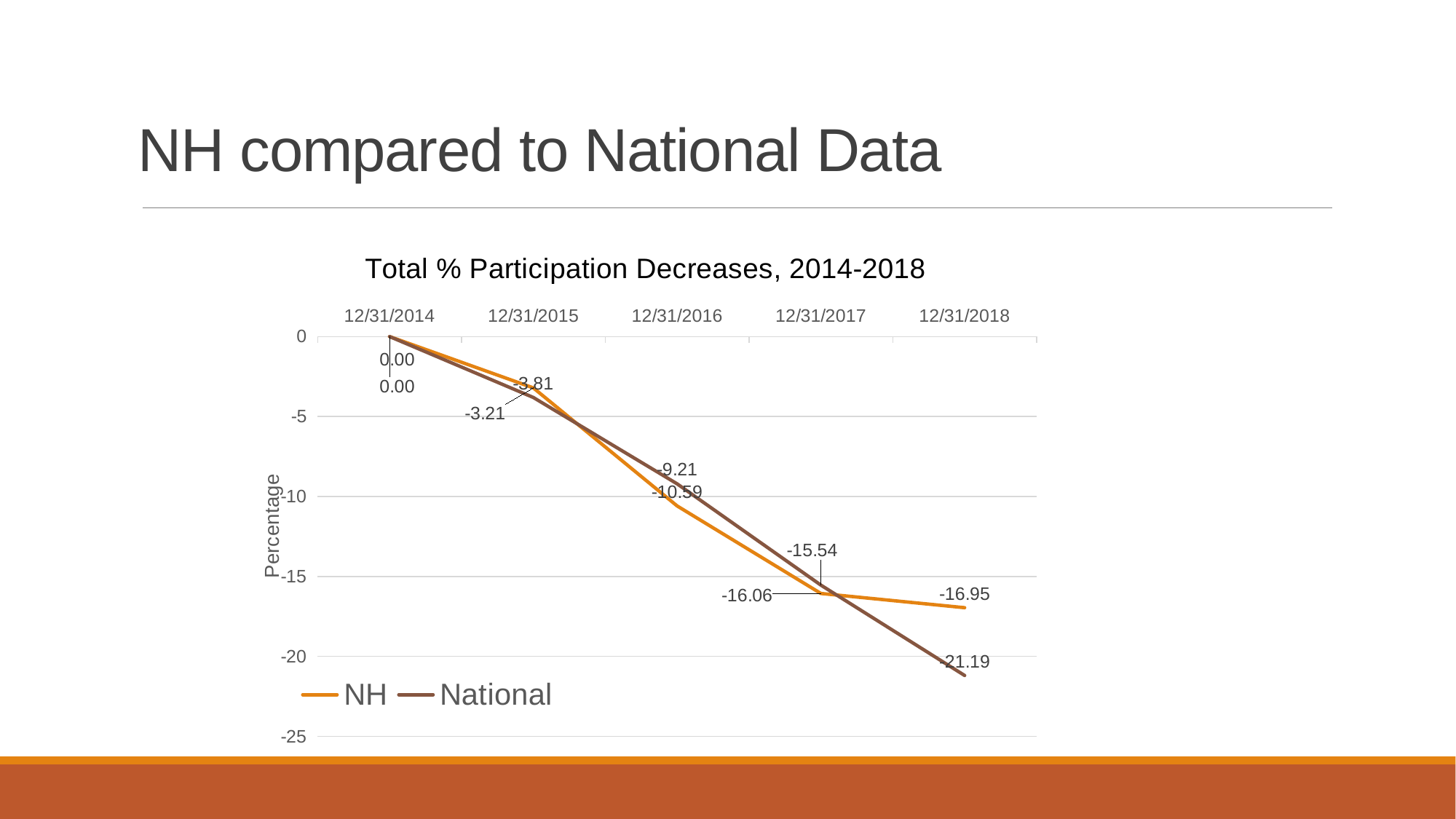
What is the difference between the National and NH values at 12/31/2018? 4.24 How many series does the legend list? 2 What kind of chart is shown on the slide? line chart Do the values for the National series rise or fall from 12/31/2014 to 12/31/2018? fall What is the NH value at 12/31/2016? -10.59 How many dates are plotted along the x axis? 5 What is the NH value at 12/31/2018? -16.95 What is the title of the chart? Total % Participation Decreases, 2014-2018 What is the National value at 12/31/2017? -15.54 At which date does the National series reach its lowest value? 12/31/2018 What is the National value at 12/31/2018? -21.19 At 12/31/2018, which series has the lower value, NH or National? National